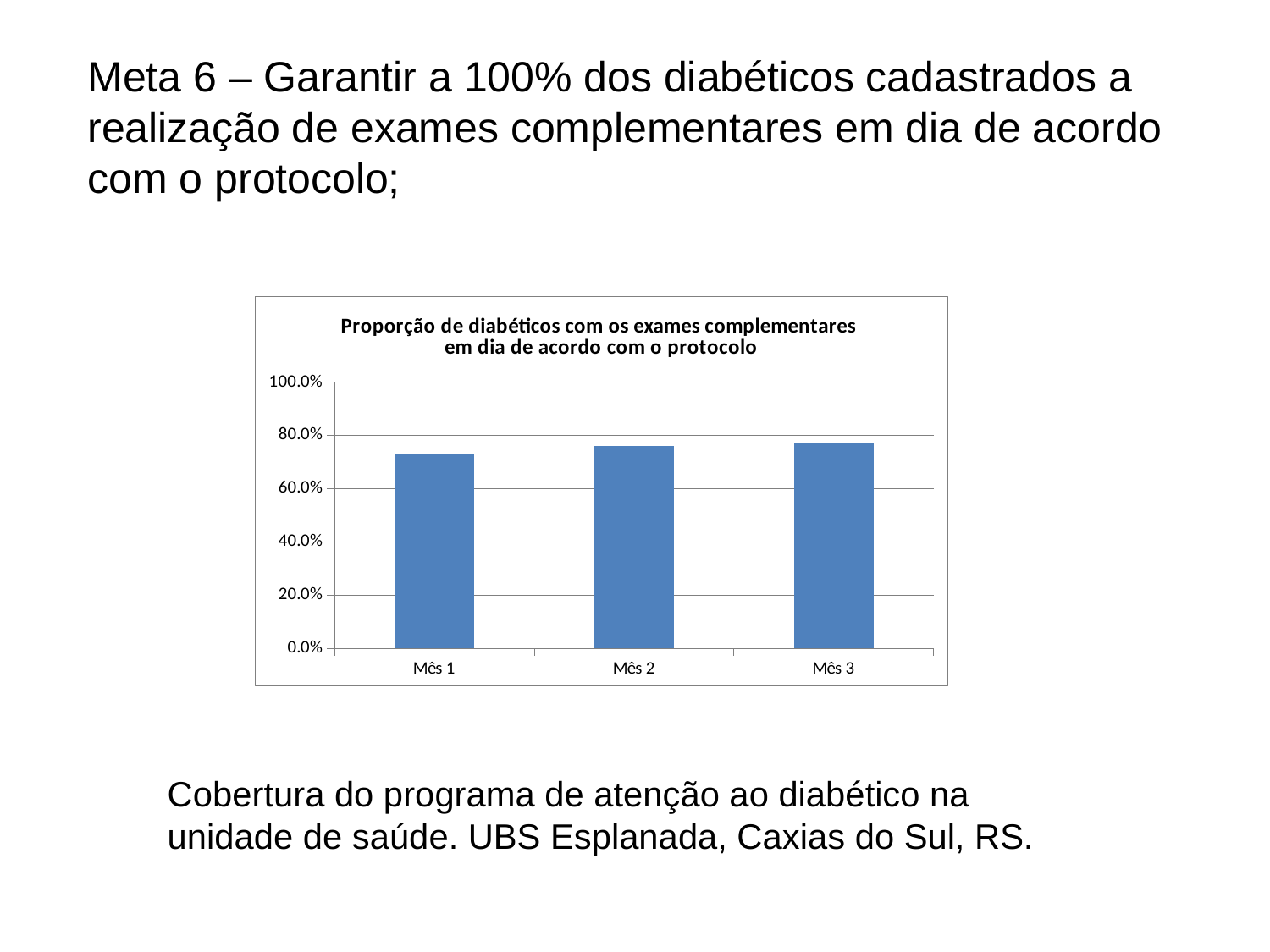
Is the value for Mês 1 greater or less than 60.0%? greater What is the title of the chart? Proporção de diabéticos com os exames complementares em dia de acordo com o protocolo Which is larger, the value for Mês 1 or the value for Mês 3? Mês 3 Which month has the lowest proportion of diabetics with complementary exams up to date? Mês 1 How many categories (months) are plotted in the chart? 3 What kind of chart is shown on the slide? bar chart Do the values rise or fall from Mês 1 to Mês 3? rise Is the value for Mês 1 greater or less than 80.0%? less Is the value for Mês 2 greater or less than 80.0%? less What is the highest value shown on the vertical axis of the chart? 100.0%